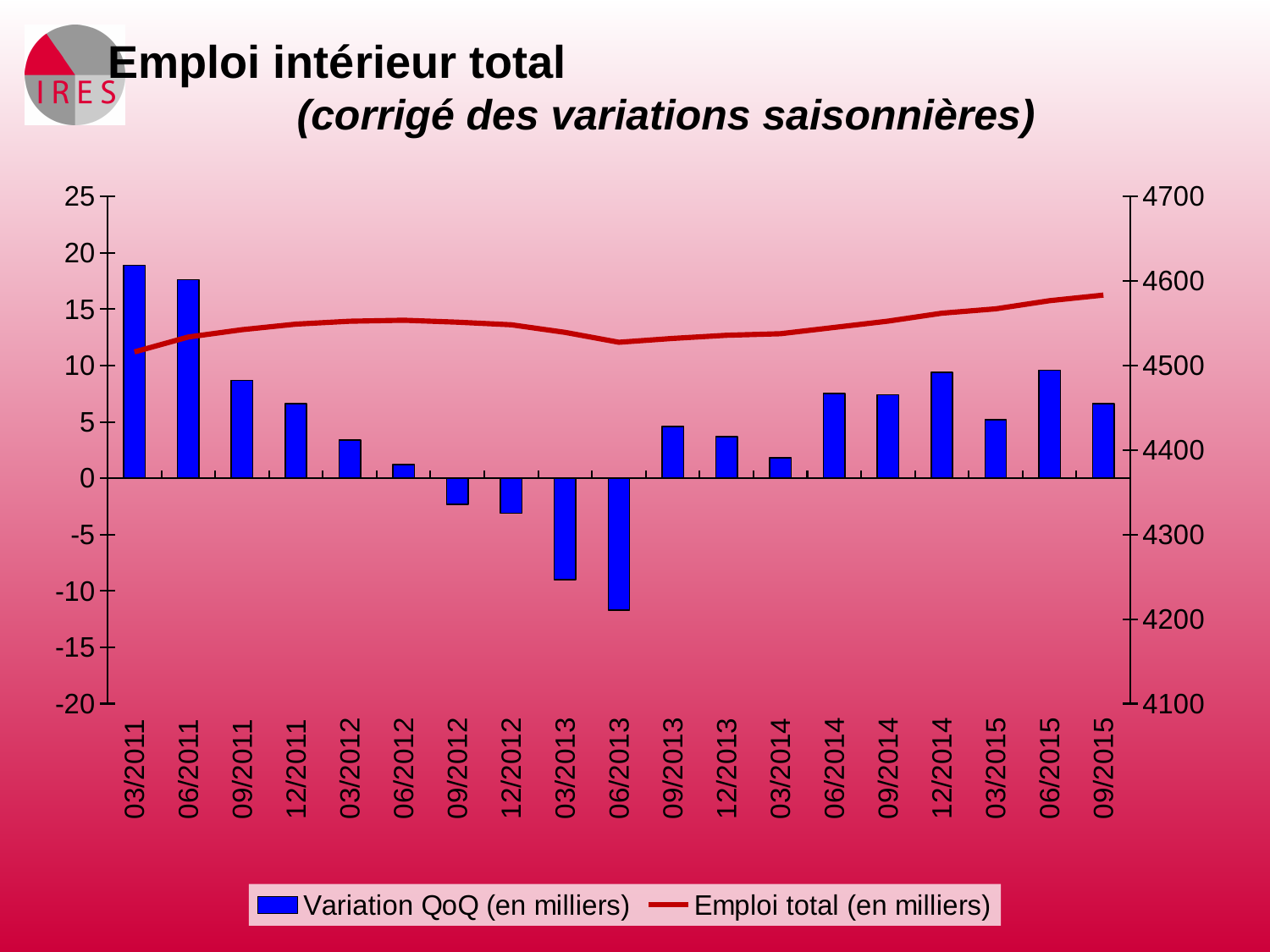
Which quarter has the larger Variation QoQ bar, 03/2015 or 06/2015? 06/2015 Is the Emploi total value for 09/2015 greater or less than 4500? greater Which quarter has the highest bar for Variation QoQ (en milliers)? 03/2011 Does the Emploi total line rise or fall from 06/2013 to 09/2015? rises Which quarter has the lowest bar for Variation QoQ (en milliers)? 06/2013 What colour are the Variation QoQ bars? Blue Is the Variation QoQ value for 06/2013 greater or less than -10? less Is the Variation QoQ value for 12/2014 greater or less than 5? greater What kind of chart is shown on the slide? A combined bar and line chart How many series does the legend list? 2 How many quarters (categories) are shown on the x axis? 19